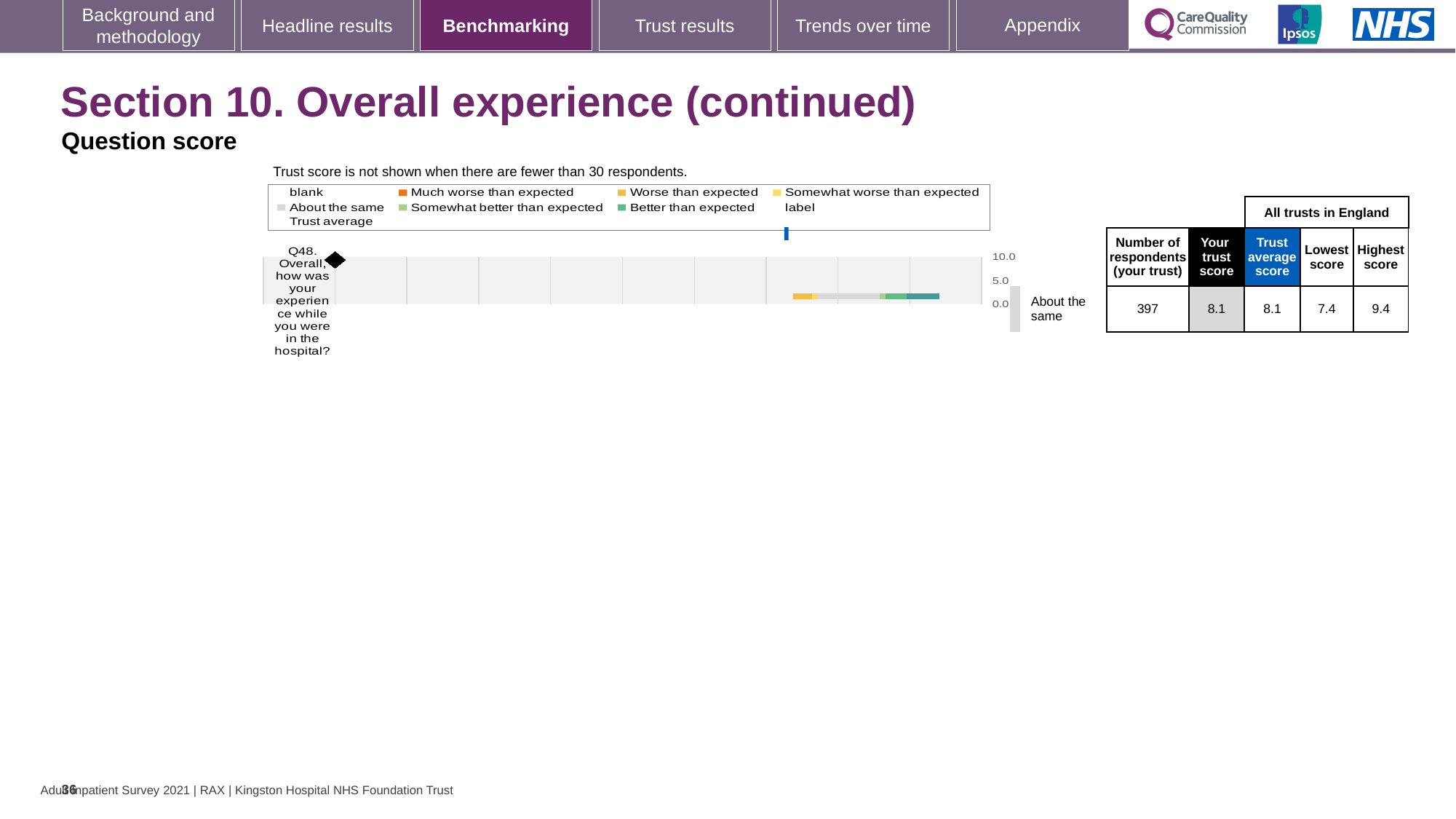
According to the note above the chart, below how many respondents is the trust score not shown? 30 What is the number of respondents for your trust for Q48? 397 How many survey questions are plotted in the chart? 1 Which question number is plotted in the chart? Q48 What is the lowest score among all trusts in England for Q48? 7.4 What is your trust score for Q48? 8.1 What benchmark category is shown for Q48 next to the chart? About the same What is the difference between the highest score and the lowest score for Q48? 2.0 What is the trust average score for Q48? 8.1 What kind of chart is shown on the slide? bar chart What is the highest score among all trusts in England for Q48? 9.4 What is the difference between the highest score and your trust score for Q48? 1.3